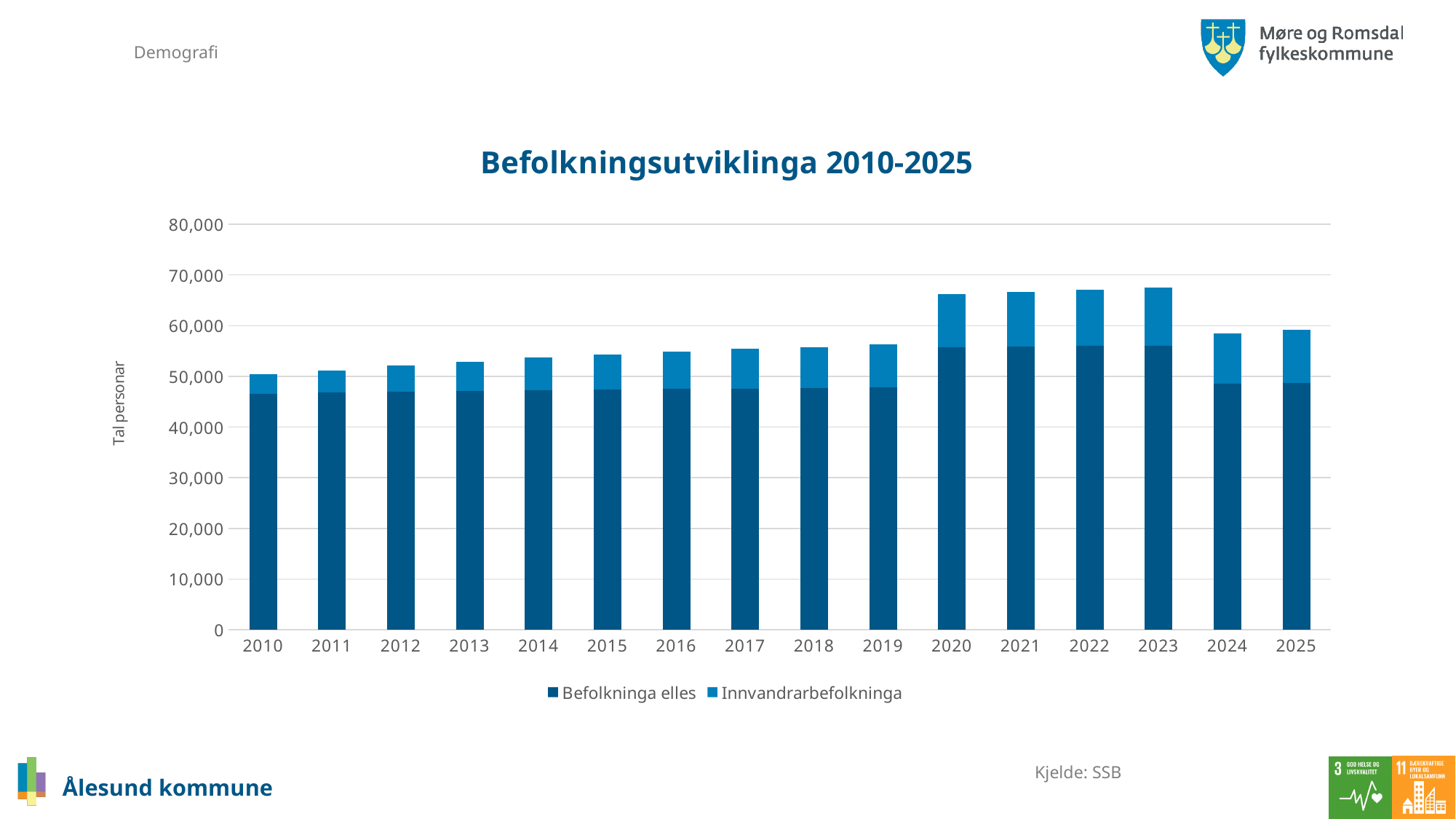
Is the total value for 2023 greater or less than 60,000? greater Which year has the larger total bar, 2020 or 2019? 2020 Which year has the lowest total bar? 2010 How many series does the legend list? 2 Is the value for Befolkninga elles in 2020 greater or less than 50,000? greater Is the total value for 2019 greater or less than 60,000? less How many years are shown on the x axis? 16 Do the total bars rise or fall from 2010 to 2019? rise Which year has the highest total bar? 2023 What is the title of the chart? Befolkningsutviklinga 2010-2025 What kind of chart is shown on the slide? bar chart